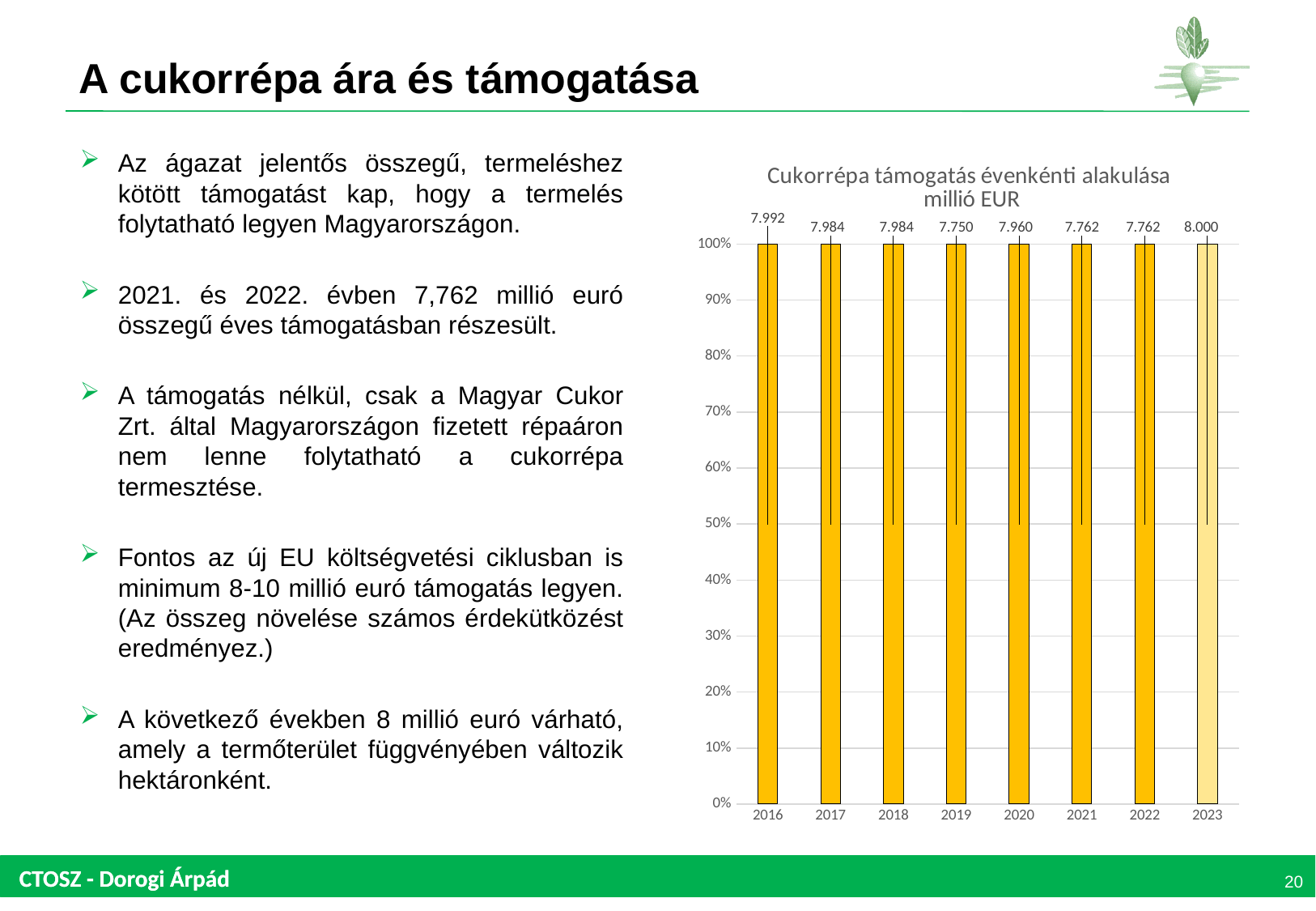
Which year has the highest value in the chart? 2023 What is the value shown for 2023 in the chart? 8.000 What kind of chart is shown on the slide? Bar chart What is the value shown for 2019 in the chart? 7.750 Which year has the lowest value in the chart? 2019 What is the difference between the values for 2023 and 2019? 0.250 Which is larger, the value for 2016 or the value for 2020? 2016 What is the title of the chart? Cukorrépa támogatás évenkénti alakulása millió EUR What is the value shown for 2016 in the chart? 7.992 What is the difference between the values for 2020 and 2019? 0.210 How many years are shown on the x axis of the chart? 8 What is the value shown for 2021 in the chart? 7.762